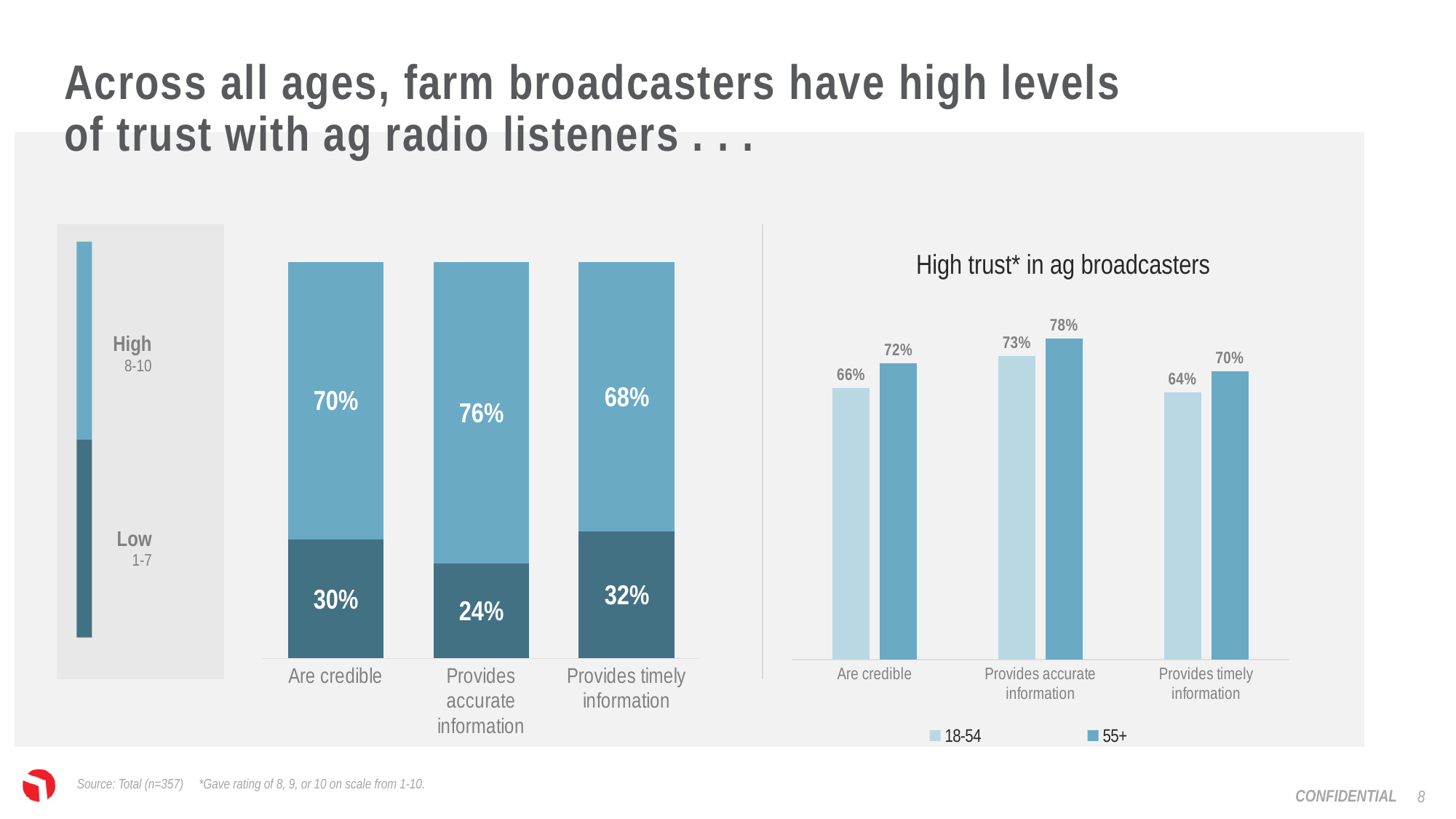
In the left stacked bar chart, what is the total of the High and Low segments for 'Are credible'? 100% In the left stacked bar chart, what is the Low (1-7) value for 'Provides timely information'? 32% In the 'High trust* in ag broadcasters' chart, which is larger for 'Are credible': 18-54 or 55+? 55+ In the left stacked bar chart, which category has the highest High (8-10) share? Provides accurate information How many series does the legend of the 'High trust* in ag broadcasters' chart list? 2 In the left stacked bar chart, what is the difference between the High values for 'Provides accurate information' and 'Provides timely information'? 8% What type of chart is the 'High trust* in ag broadcasters' chart? Bar chart In the left stacked bar chart, what is the High (8-10) value for 'Provides accurate information'? 76% In the 'High trust* in ag broadcasters' chart, what is the value for 55+ on 'Provides accurate information'? 78% In the left stacked bar chart, which category has the lowest Low (1-7) share? Provides accurate information In the 'High trust* in ag broadcasters' chart, what is the value for 18-54 on 'Provides timely information'? 64% In the 'High trust* in ag broadcasters' chart, what is the difference between 55+ and 18-54 for 'Provides timely information'? 6%